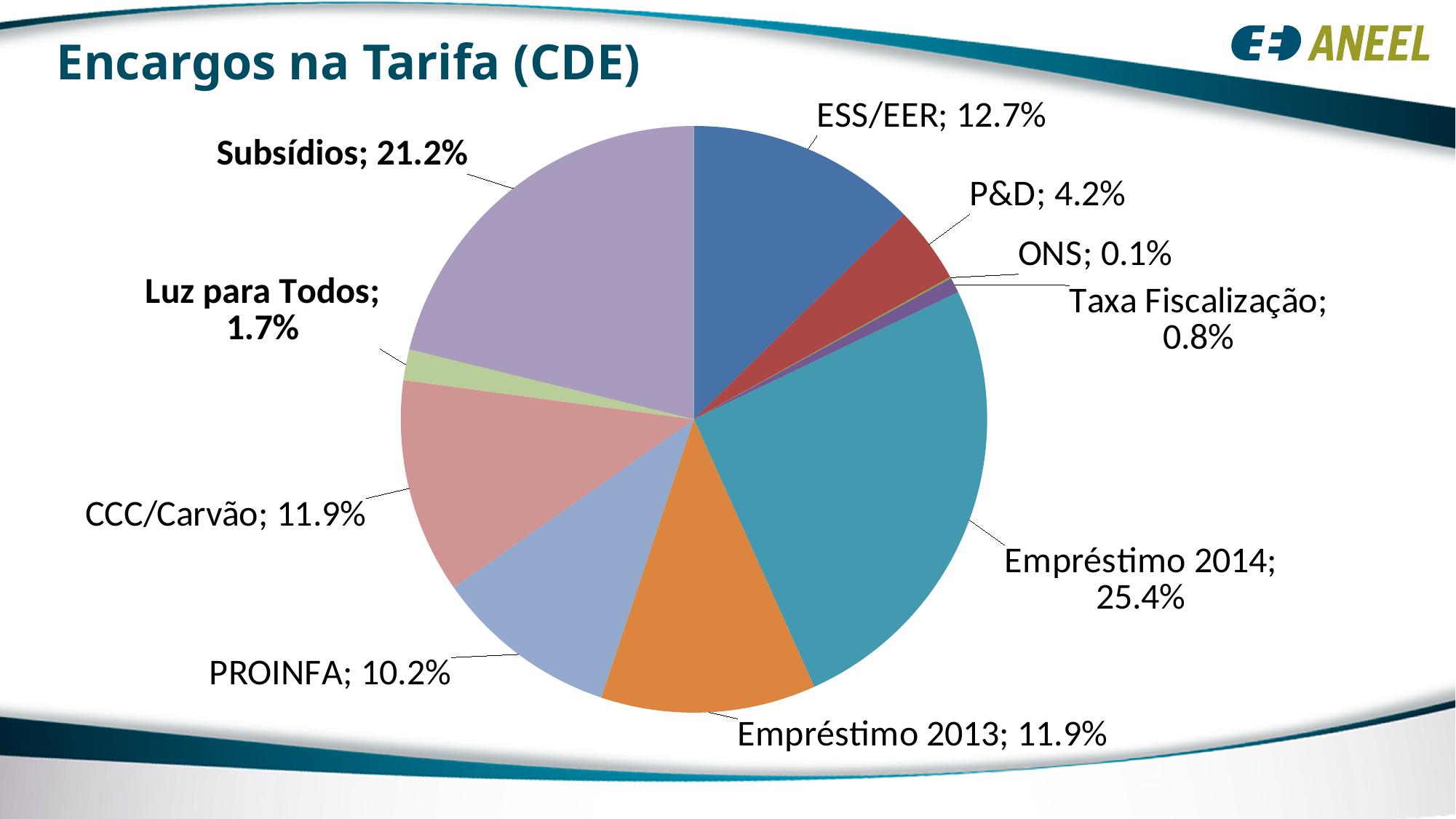
What type of chart is shown on the slide? pie chart What is the value shown for Subsídios? 21.2% What is the difference between the shares of Empréstimo 2014 and Subsídios? 4.2% Which is larger, the share for CCC/Carvão or the share for PROINFA? CCC/Carvão What is the title of the chart? Encargos na Tarifa (CDE) Which category has the smallest share of the pie? ONS What is the value shown for Taxa Fiscalização? 0.8% Which category has the largest share of the pie? Empréstimo 2014 What is the value shown for PROINFA? 10.2% What is the difference between the shares of ESS/EER and P&D? 8.5% What share of the pie does Empréstimo 2014 represent? 25.4% How many slices does the pie chart have? 10